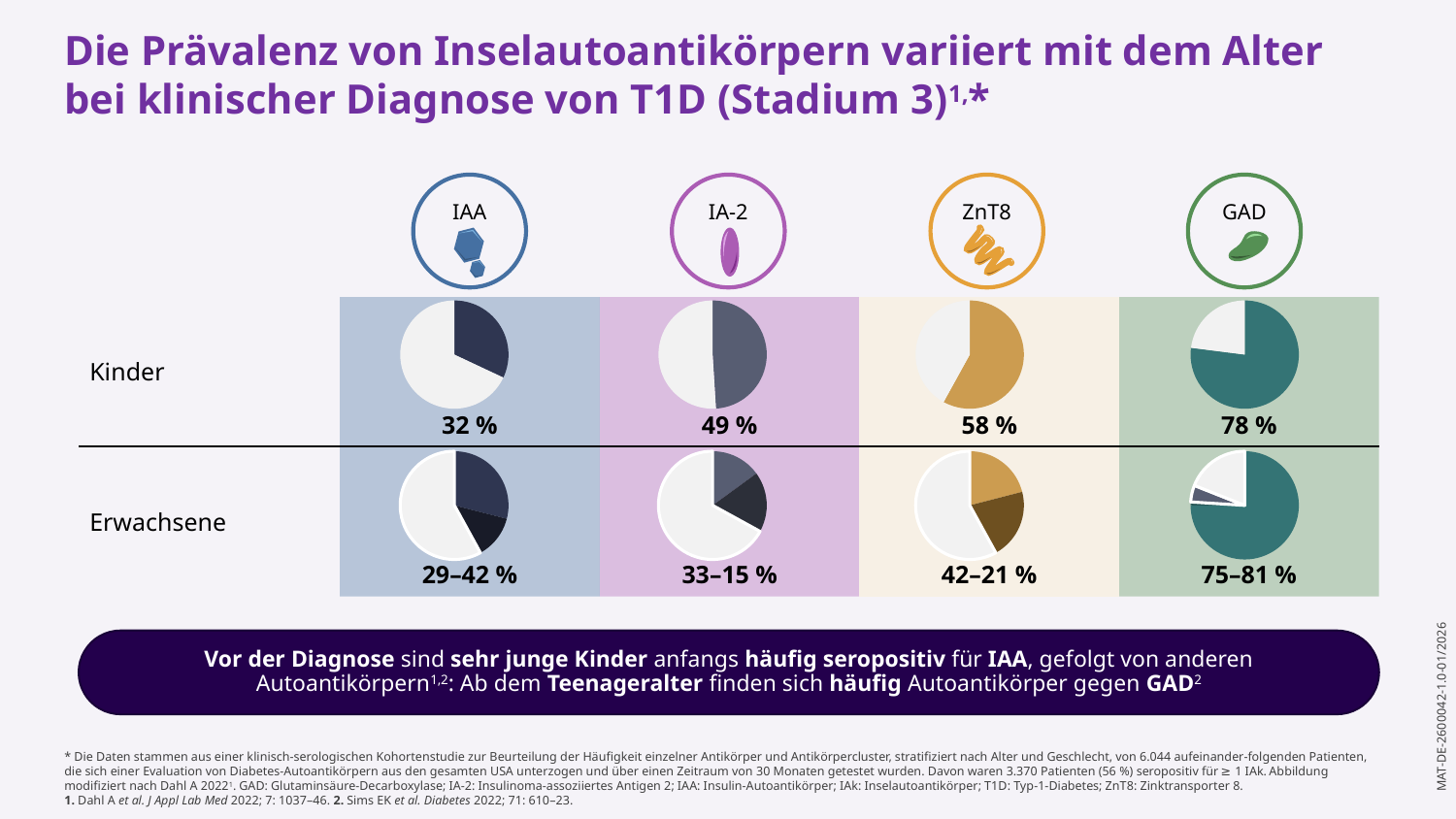
What kind of charts are used to show the prevalence values on the slide? Pie charts In the Kinder row, what is the value shown for GAD? 78 % Which four autoantibodies are labelled above the columns of pie charts? IAA, IA-2, ZnT8, GAD How many pie charts are shown on the slide in total? 8 In the Kinder row, what is the value shown for IAA? 32 % In the Kinder row, which autoantibody has the lowest prevalence? IAA In the Erwachsene row, what value range is shown for IA-2? 33–15 % In the Kinder row, which autoantibody has the highest prevalence? GAD In the Erwachsene row, what value range is shown for GAD? 75–81 % In the Kinder row, what is the value shown for ZnT8? 58 % In the Kinder row, which is larger: the value for IA-2 or the value for ZnT8? ZnT8 In the Kinder row, what is the difference between the GAD value and the IAA value? 46 %